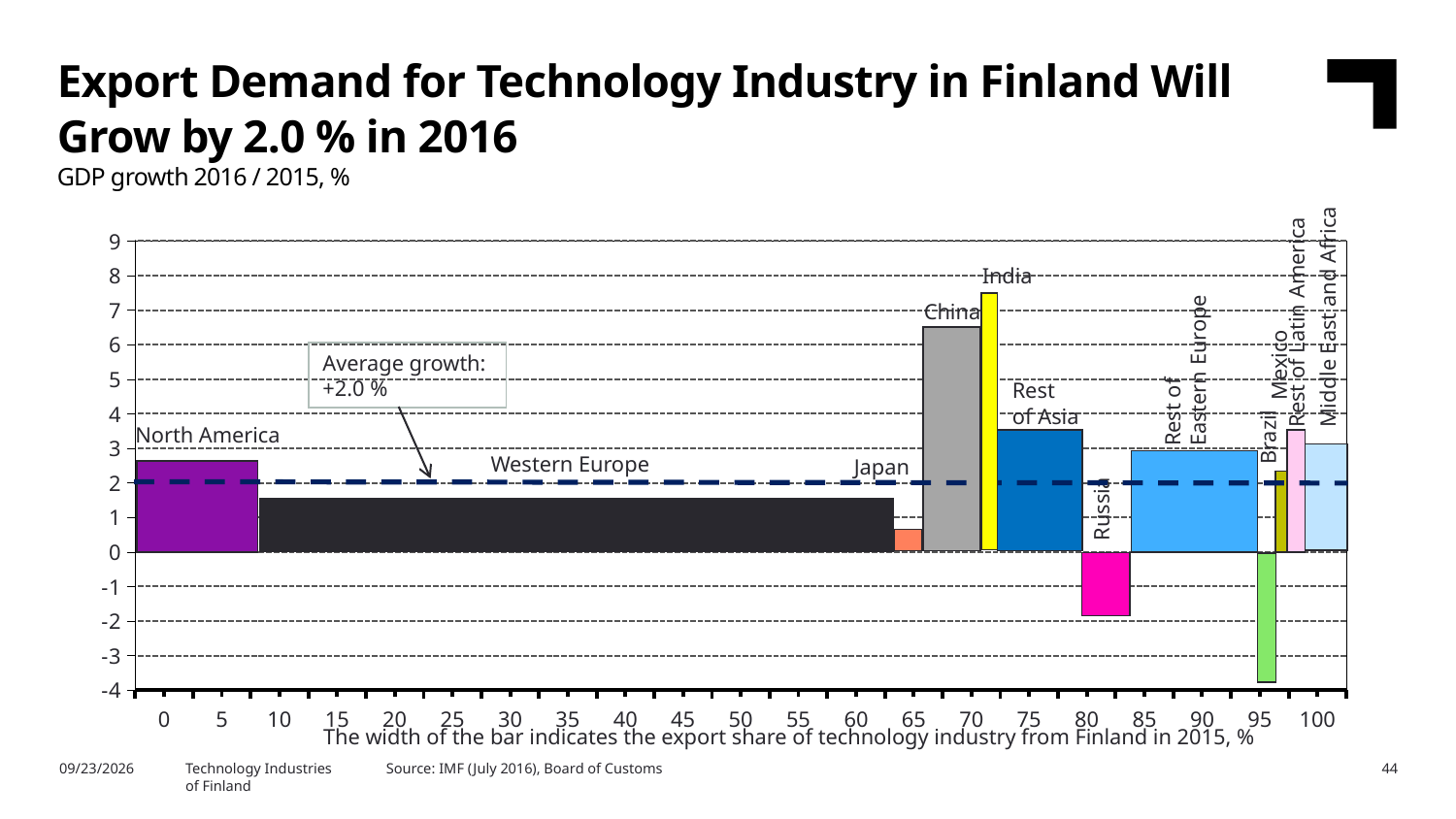
What average growth value is shown in the annotation box on the chart? +2.0 % Is the GDP growth value for Western Europe greater or less than 2? less Which region has the highest GDP growth in the chart? India How many regions are shown as bars in the chart? 12 Which has the higher GDP growth, India or China? India What kind of chart is shown on the slide? bar chart According to the note below the x axis, what does the width of each bar indicate? The export share of technology industry from Finland in 2015, % Is the GDP growth value for China greater or less than 6? greater Is the GDP growth value for Russia greater or less than -1? less Which has the higher GDP growth, Mexico or Rest of Latin America? Rest of Latin America Which region has the lowest GDP growth in the chart? Brazil